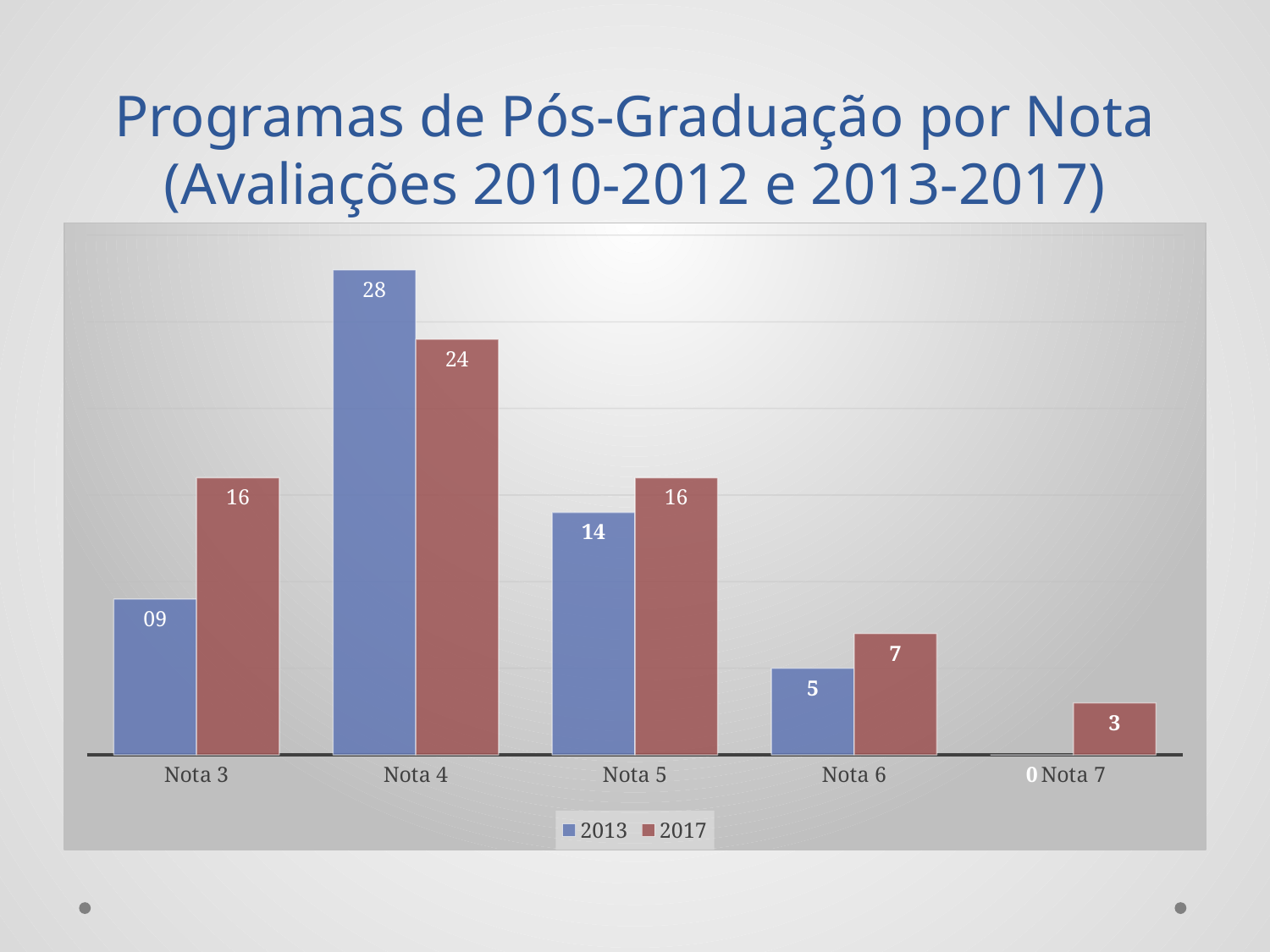
What is the title of the chart on the slide? Programas de Pós-Graduação por Nota (Avaliações 2010-2012 e 2013-2017) How many categories are shown on the x axis? 5 What is the difference between the 2013 and 2017 values for Nota 4? 4 What is the value for Nota 3 in the 2013 series? 09 How many series does the legend list? 2 Which is larger for Nota 5: the 2013 value or the 2017 value? 2017 What kind of chart is shown on the slide? bar chart Which category has the lowest value in the 2013 series? Nota 7 Which category has the highest value in the 2017 series? Nota 4 What is the value for Nota 4 in the 2013 series? 28 What is the total of the 2013 and 2017 values for Nota 6? 12 What is the value for Nota 7 in the 2017 series? 3